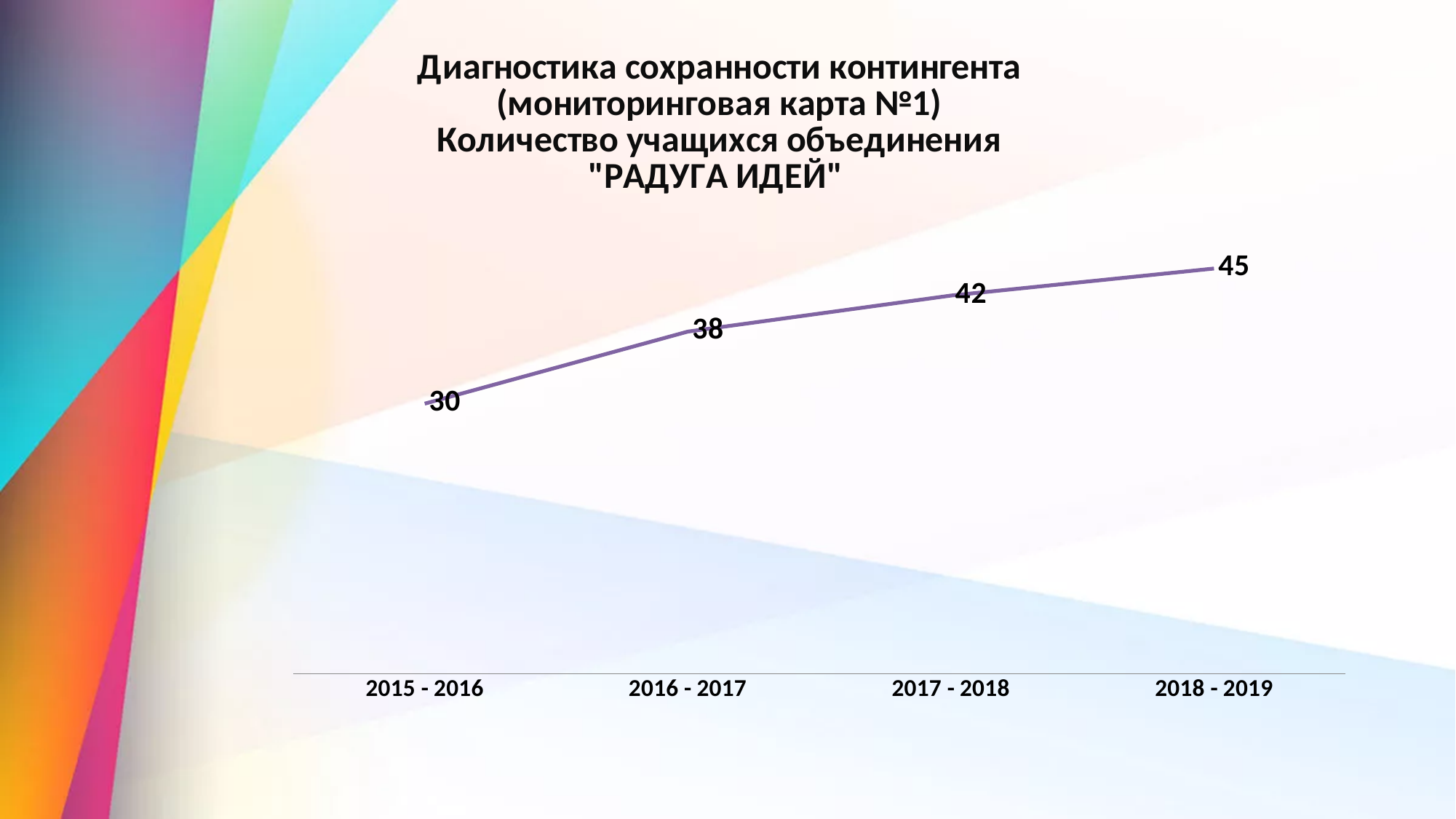
Which academic year has the highest number of students? 2018 - 2019 What is the difference between the number of students in 2016 - 2017 and 2015 - 2016? 8 What is the difference between the number of students in 2018 - 2019 and 2015 - 2016? 15 What kind of chart is shown on the slide? Line chart What is the number of students for 2018 - 2019? 45 What is the number of students for 2016 - 2017? 38 Do the values rise or fall from 2015 - 2016 to 2018 - 2019? Rise Which academic year has the lowest number of students? 2015 - 2016 What is the number of students for 2015 - 2016? 30 What is the number of students for 2017 - 2018? 42 How many academic years are plotted on the chart? 4 Which has more students, 2017 - 2018 or 2016 - 2017? 2017 - 2018